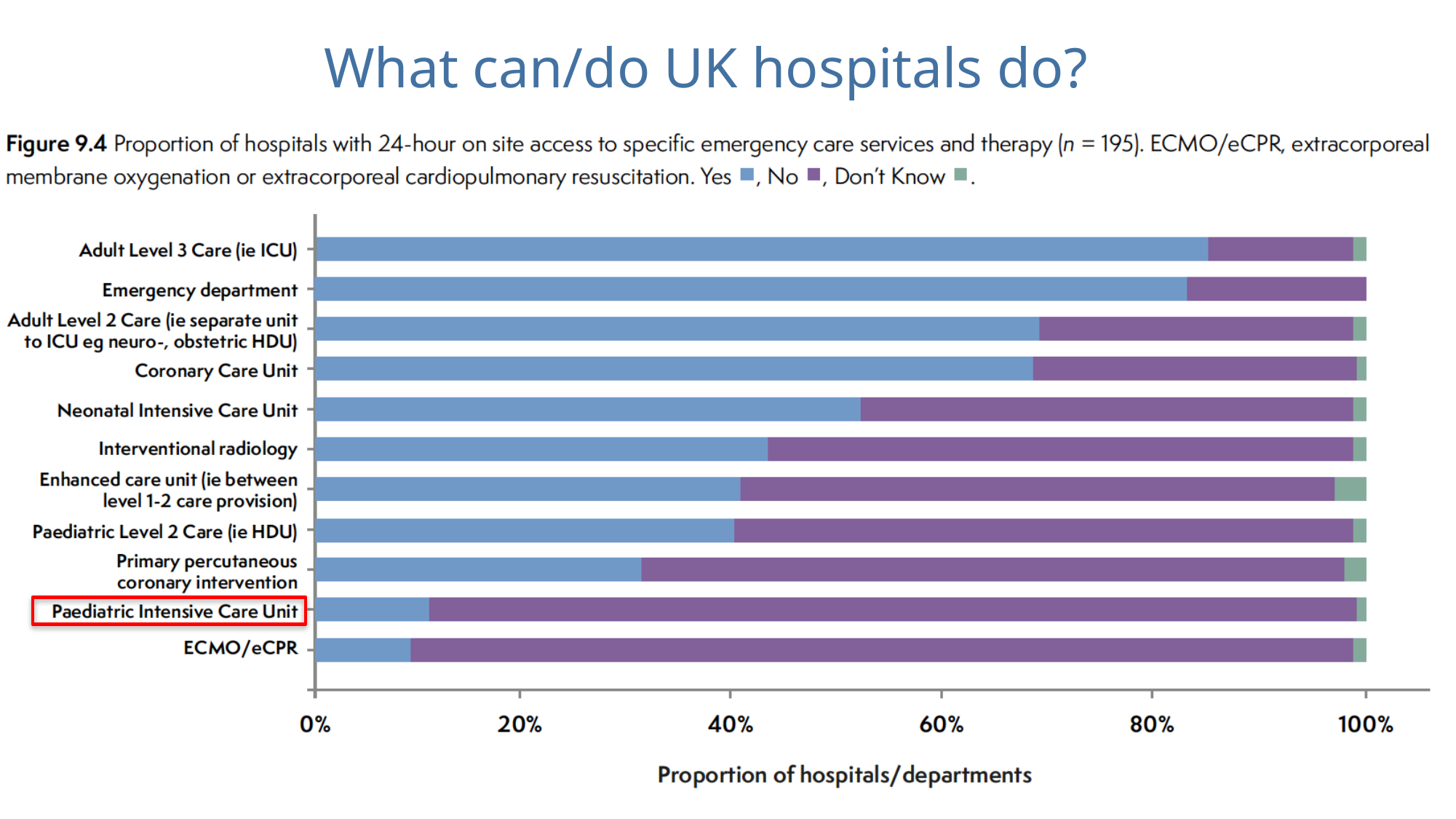
Which category has the highest proportion of hospitals answering 'Yes'? Adult Level 3 Care (ie ICU) Which has a larger 'Yes' proportion: Neonatal Intensive Care Unit or Interventional radiology? Neonatal Intensive Care Unit How many series does the legend list? 3 Is the 'Yes' proportion for Primary percutaneous coronary intervention greater or less than 40%? less What kind of chart is shown on the slide? Stacked bar chart Is the 'Yes' proportion for Adult Level 3 Care (ie ICU) greater or less than 80%? greater What colour represents the 'Yes' responses in the chart? Blue Is the 'Yes' proportion for Paediatric Intensive Care Unit greater or less than 20%? less Which category is highlighted with a red box on the slide? Paediatric Intensive Care Unit Does the 'Yes' proportion rise or fall moving down the list of categories from top to bottom? fall How many service categories are listed on the chart? 11